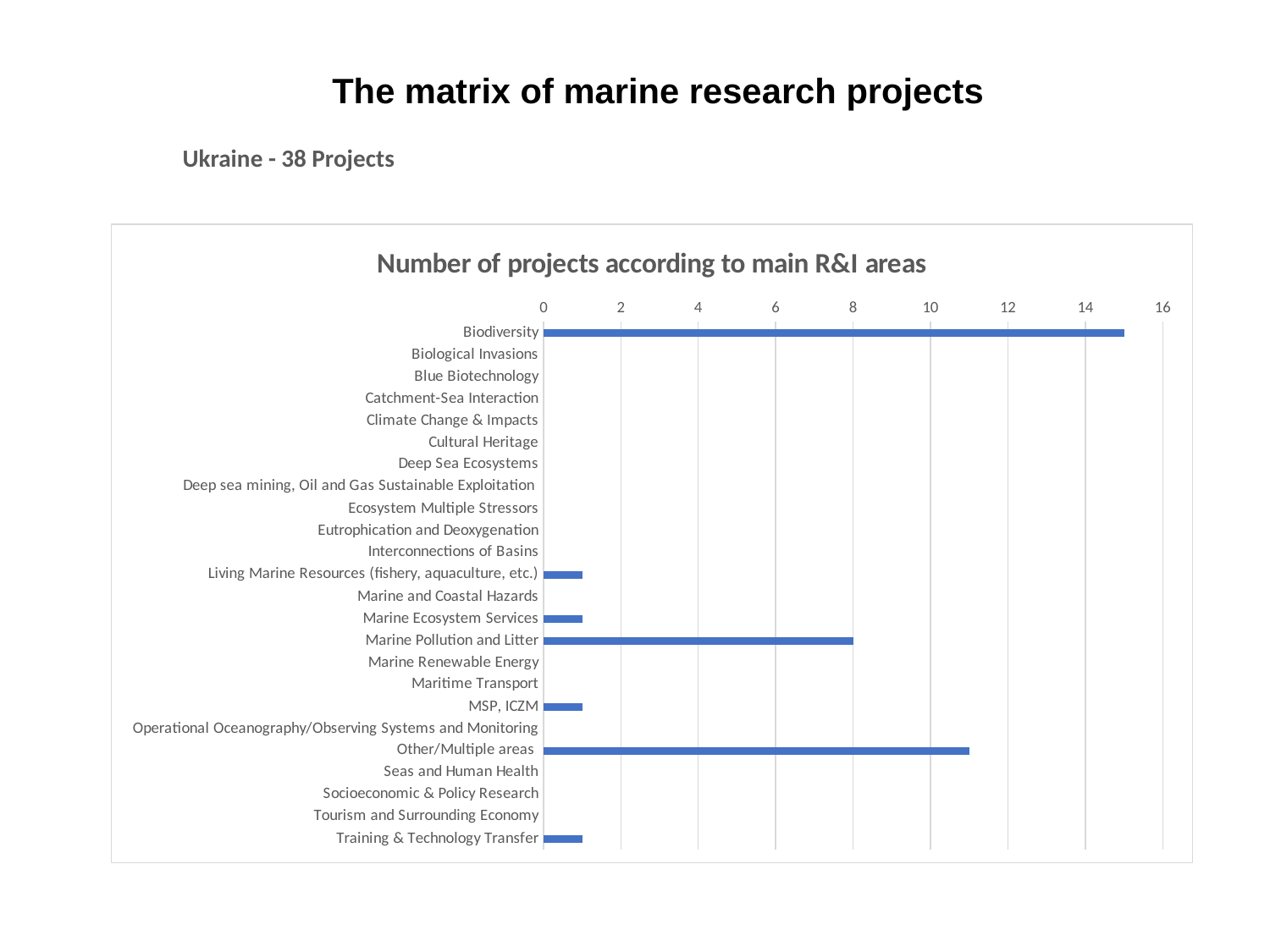
Which has more projects, Other/Multiple areas or Marine Pollution and Litter? Other/Multiple areas Is the value for Biodiversity greater or less than 14? greater How many R&I area categories are listed on the chart's axis? 24 Is the value for MSP, ICZM greater or less than 2? less What is the maximum value shown on the chart's value axis? 16 Which R&I area has the highest number of projects? Biodiversity How many projects are in the Marine Pollution and Litter area? 8 What kind of chart is shown on the slide? bar chart Is the value for Other/Multiple areas greater or less than 10? greater What is the title of the chart? Number of projects according to main R&I areas Which has more projects, Biodiversity or Other/Multiple areas? Biodiversity